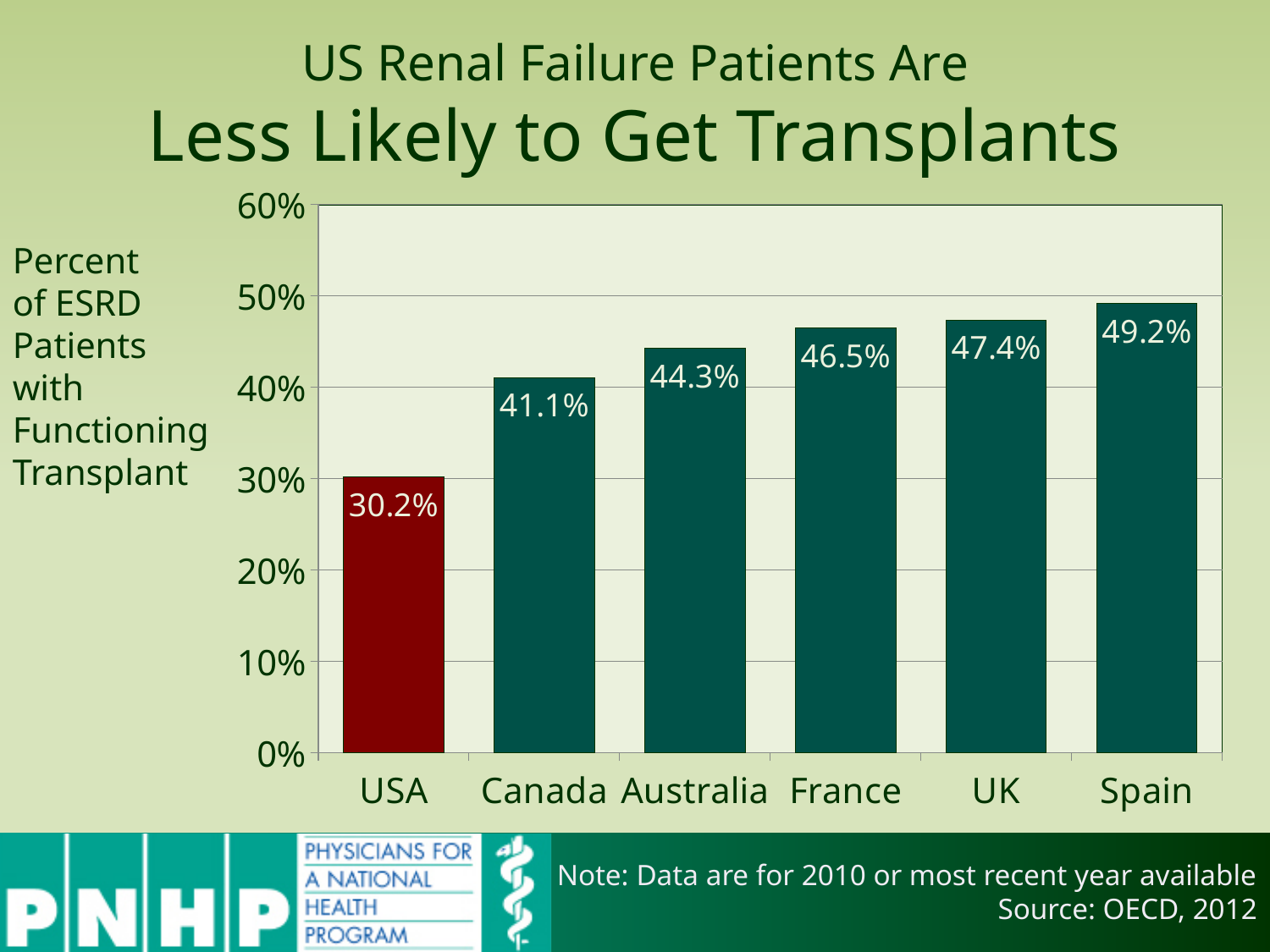
What is the value shown for France? 46.5% How many countries are shown on the chart? 6 Which country has the highest percent of ESRD patients with a functioning transplant? Spain Which bar is coloured differently (dark red) from the others? USA Which country has the lowest percent of ESRD patients with a functioning transplant? USA What kind of chart is shown on the slide? Bar chart What is the difference between the values for the UK and Australia? 3.1% What is the value shown for Canada? 41.1% Which has a higher value, Canada or Australia? Australia What is the percent of ESRD patients with a functioning transplant for the USA? 30.2% Is the value for the UK greater or less than 50%? less What is the difference between the values for Spain and the USA? 19.0%